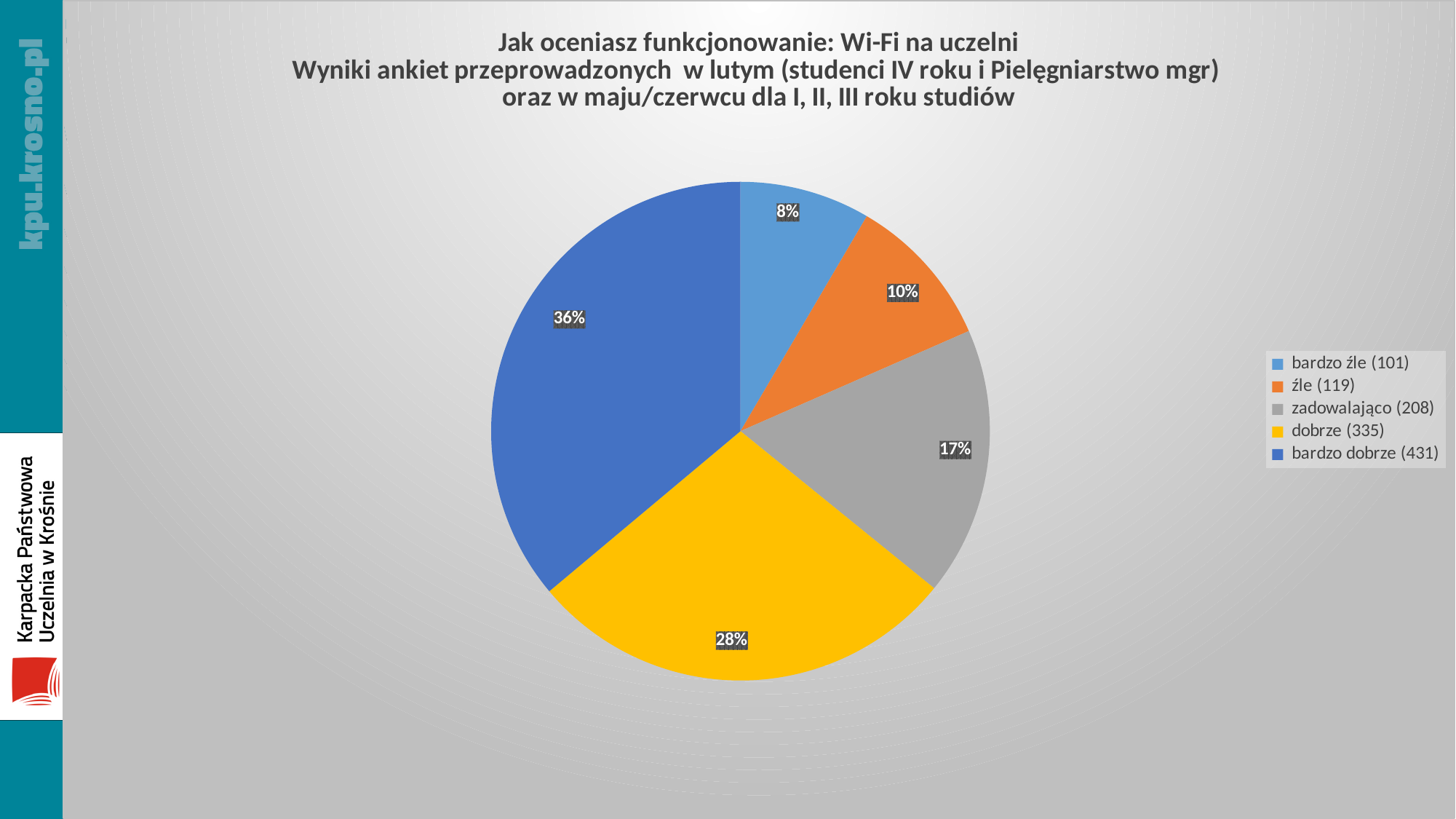
What percentage share does the 'źle (119)' slice have? 10% What percentage share does the 'zadowalająco (208)' slice have? 17% What percentage share does the 'dobrze (335)' slice have? 28% Which slice is larger: 'zadowalająco' or 'źle'? zadowalająco What colour is the 'dobrze (335)' slice? yellow What kind of chart is shown on the slide? pie chart Which category has the largest slice of the pie? bardzo dobrze (431) Which category has the smallest slice of the pie? bardzo źle (101) What is the difference in percentage points between the 'bardzo dobrze' slice and the 'dobrze' slice? 8 How many categories does the legend list? 5